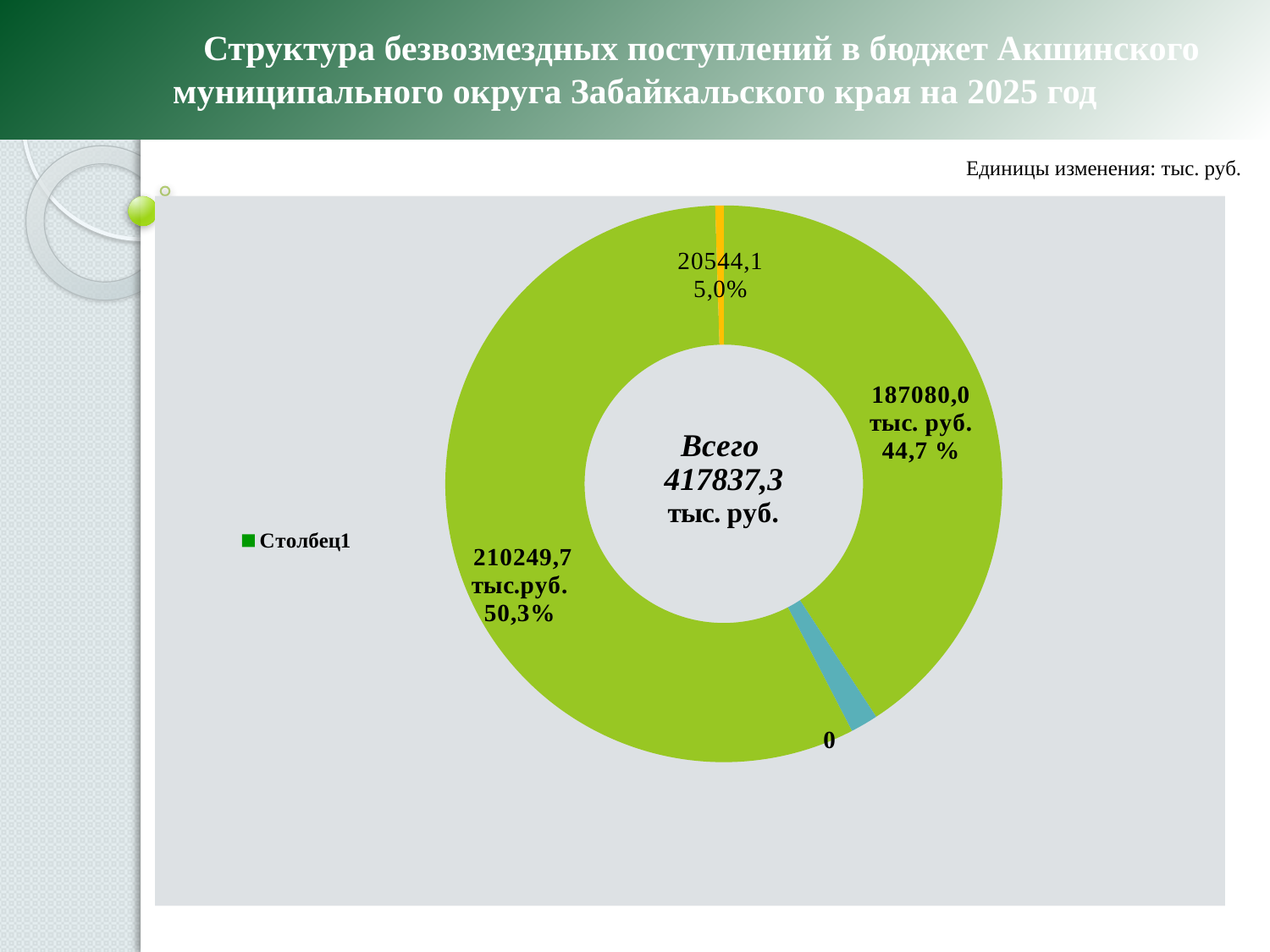
What total value is printed in the centre of the doughnut chart? 417837,3 тыс. руб. What units are stated above the chart? тыс. руб. What is the difference between the slice labelled 210249,7 тыс.руб. and the slice labelled 187080,0 тыс. руб.? 23169,7 тыс. руб. What share of the doughnut does the orange slice at the top represent? 5,0% What value is printed for the orange slice at the top of the doughnut? 20544,1 What is the share of the largest slice of the doughnut? 50,3% What value is printed for the largest slice of the doughnut? 210249,7 тыс.руб. What entry does the legend of the chart list? Столбец1 What share is printed next to the slice labelled 187080,0 тыс. руб.? 44,7 % What kind of chart is shown on the slide? doughnut chart What value is printed next to the small blue slice at the bottom right of the doughnut? 0 Which is larger: the slice labelled 210249,7 тыс.руб. or the slice labelled 187080,0 тыс. руб.? 210249,7 тыс.руб.